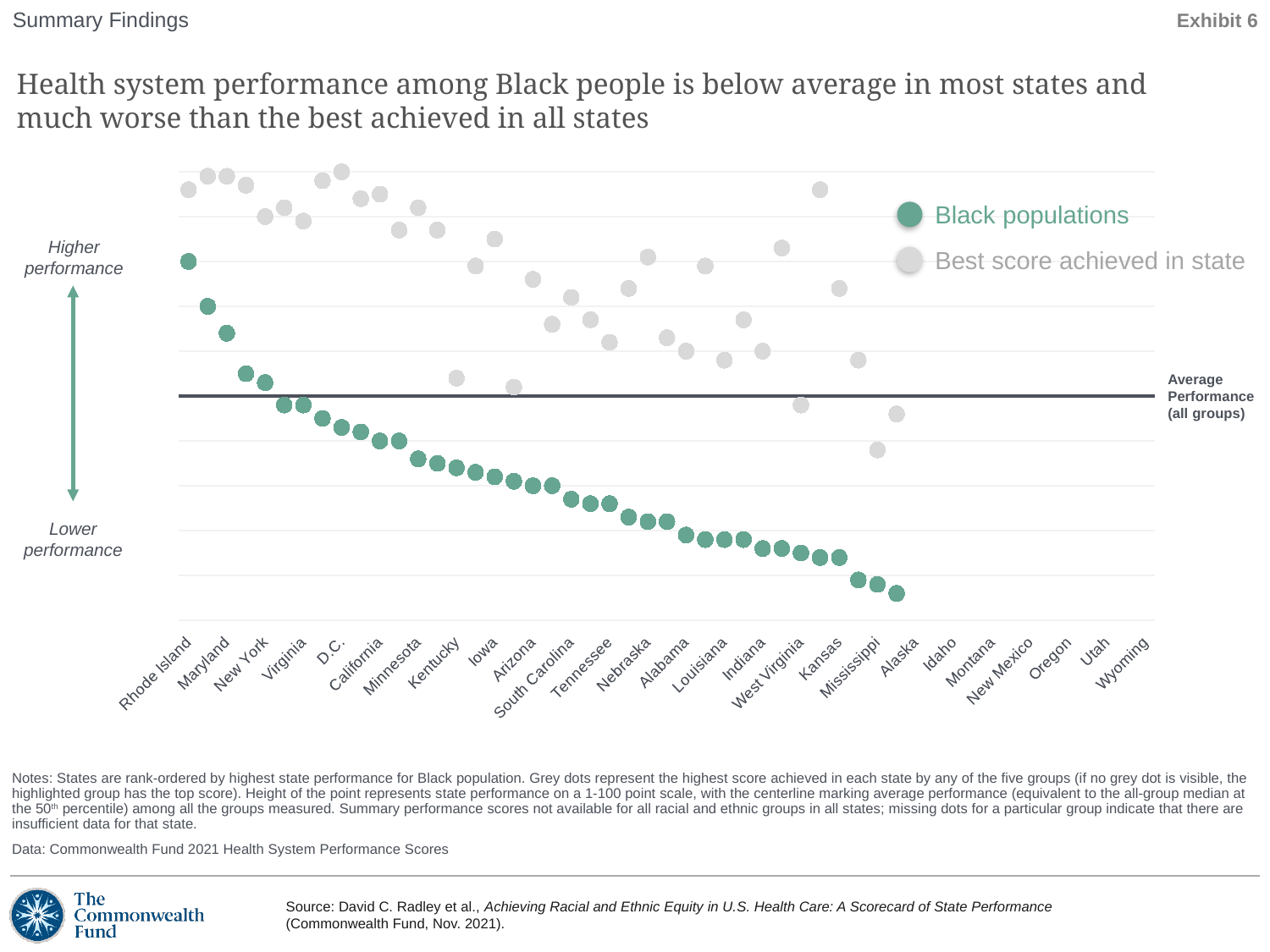
What are the two series named in the legend? Black populations; Best score achieved in state How many state labels are shown along the x axis? 26 Do the Black populations values rise or fall moving from left to right along the x axis? Fall What kind of chart is shown on the slide? Dot plot (scatter chart) Which state has the highest value for the Black populations series? Rhode Island How many series does the legend list? 2 What does the horizontal line across the chart represent? Average Performance (all groups) Is the Black populations dot for Rhode Island above or below the Average Performance (all groups) line? Above For the Black populations series, which is higher: Rhode Island or Maryland? Rhode Island Is the Black populations dot for Kentucky above or below the Average Performance (all groups) line? Below